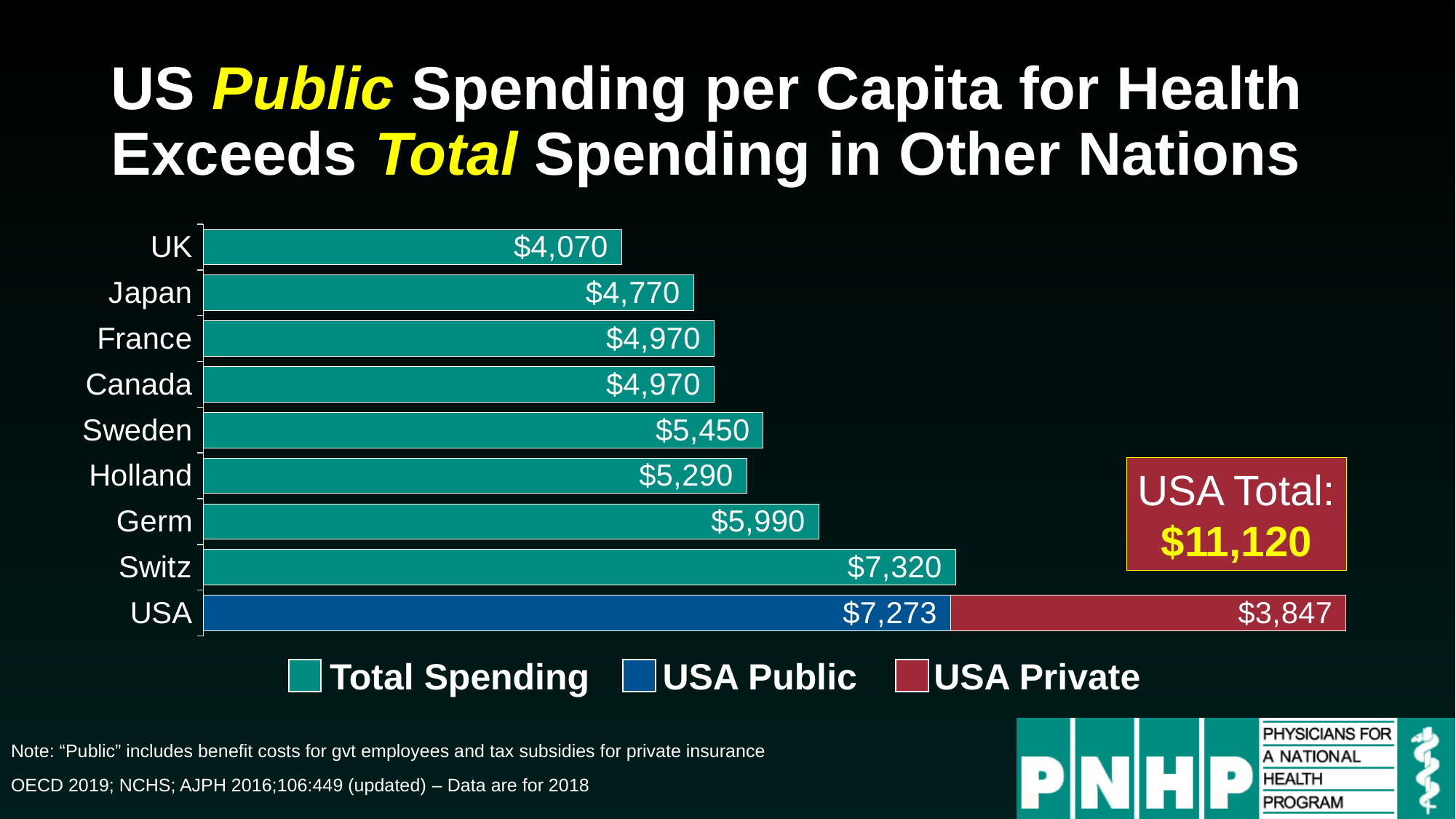
What kind of chart is shown on the slide? Bar chart What is the difference between Switzerland's total spending and Germany's total spending? $1,330 What is the total health spending per capita for the UK? $4,070 Which is larger: Sweden's total spending or Holland's total spending? Sweden How many countries are listed on the chart? 9 How many series does the legend list? 3 What is the USA Private spending per capita shown on the chart? $3,847 Which country has the lowest total spending per capita on the chart? UK Which country other than the USA has the highest total spending per capita? Switz Which legend entry is shown in red? USA Private What is the USA total spending per capita (USA Public plus USA Private)? $11,120 What is the USA Public spending per capita shown on the chart? $7,273